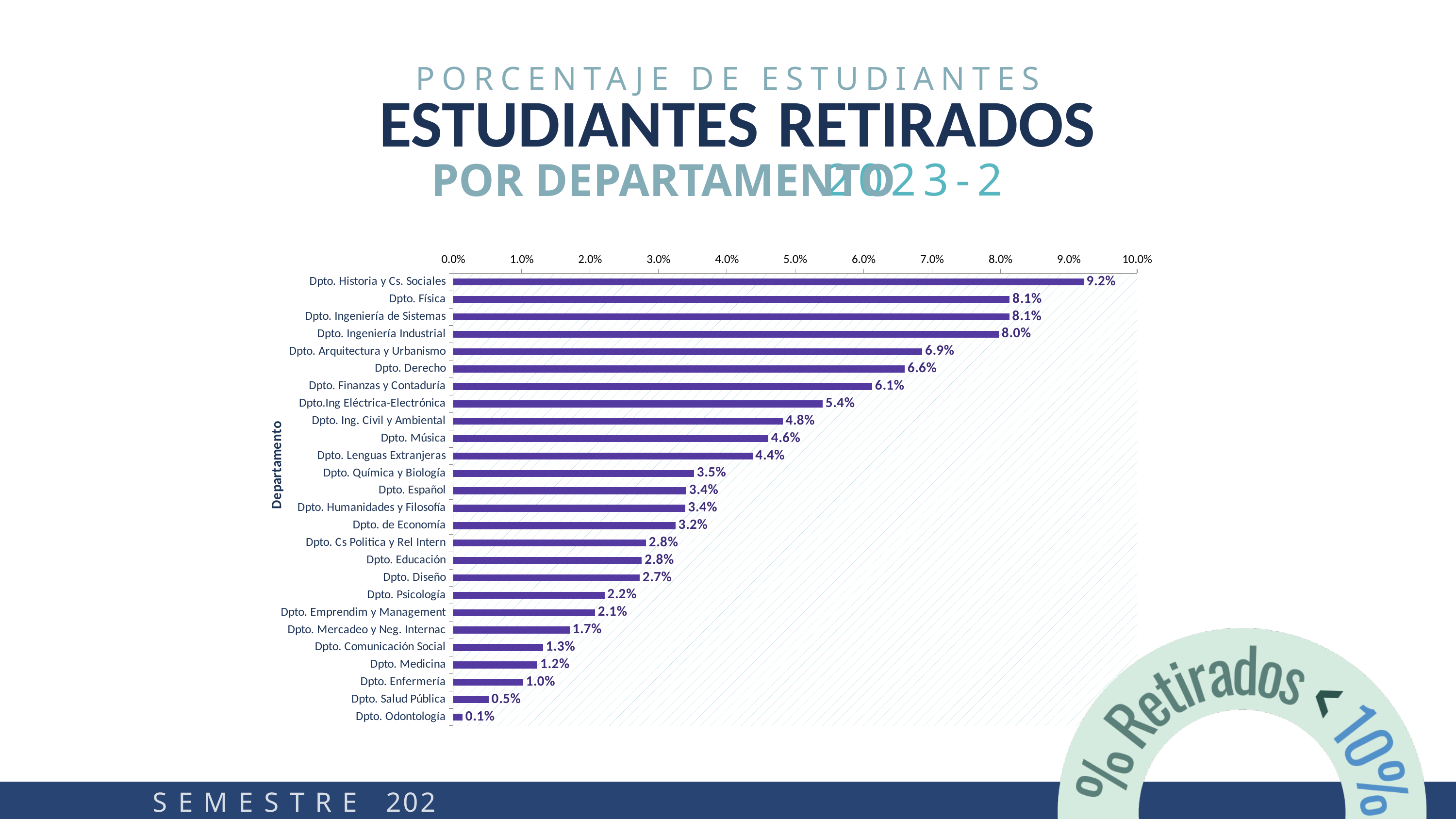
How many departments are shown in the chart? 26 What is the value for Dpto. Salud Pública? 0.5% Which is larger, the value for Dpto. Música or the value for Dpto. Lenguas Extranjeras? Dpto. Música Is the value for Dpto. Arquitectura y Urbanismo greater or less than 6.0%? greater What kind of chart is shown on the slide? bar chart What is the value for Dpto. Derecho? 6.6% What is the difference between the values for Dpto. Física and Dpto. Derecho? 1.5% Which department has the highest value? Dpto. Historia y Cs. Sociales Which department has the lowest value? Dpto. Odontología What is the value for Dpto. Historia y Cs. Sociales? 9.2% What is the value for Dpto. Psicología? 2.2% What is the label of the vertical axis? Departamento